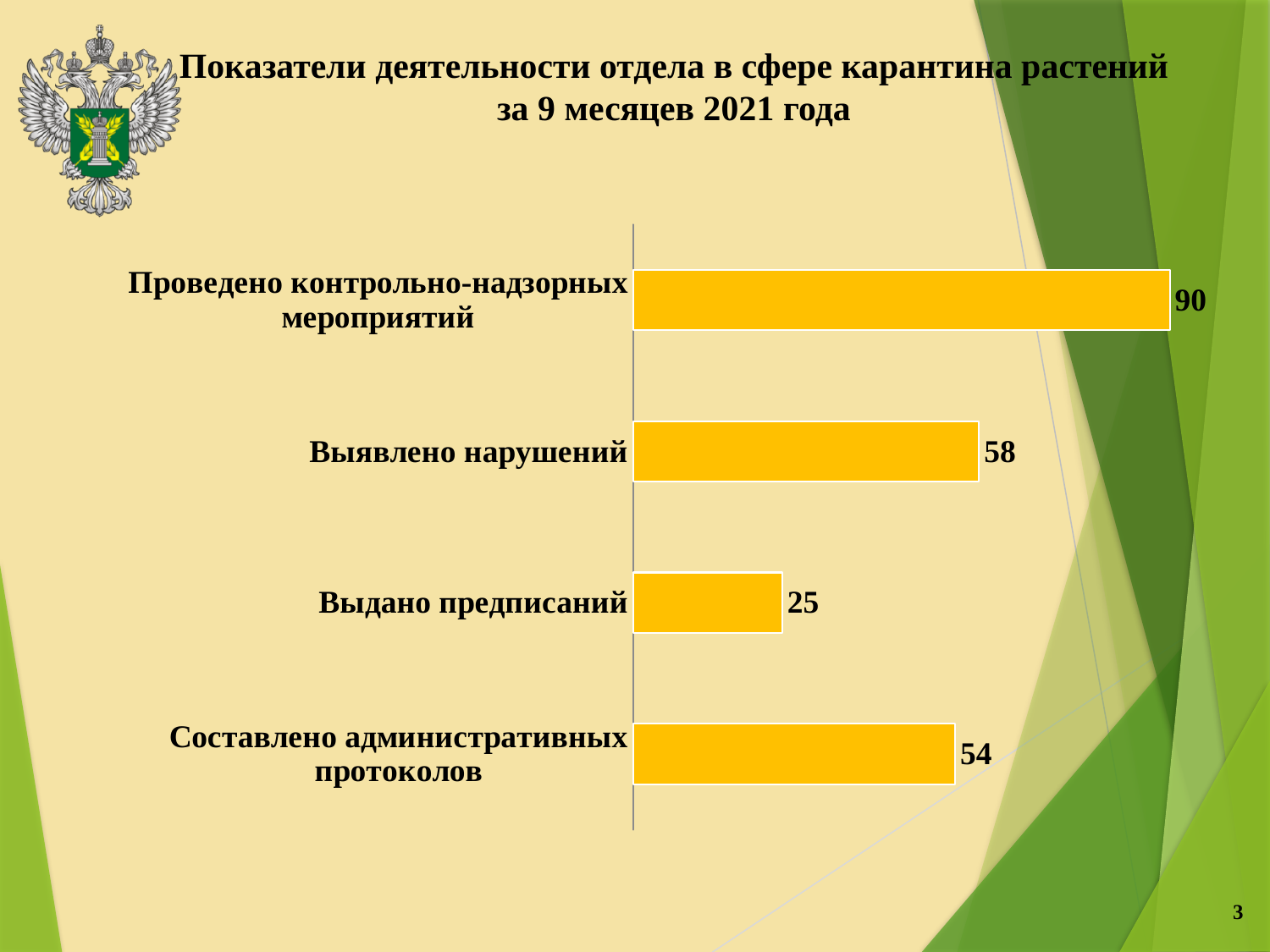
Which is larger: «Выявлено нарушений» or «Составлено административных протоколов»? Выявлено нарушений What kind of chart is shown on the slide? Bar chart What is the difference between «Проведено контрольно-надзорных мероприятий» and «Выявлено нарушений»? 32 What is the title of the slide? Показатели деятельности отдела в сфере карантина растений за 9 месяцев 2021 года What is the value for «Выявлено нарушений»? 58 Which category has the highest value? Проведено контрольно-надзорных мероприятий What is the value for «Выдано предписаний»? 25 What is the value for «Составлено административных протоколов»? 54 Which category has the lowest value? Выдано предписаний What is the difference between «Составлено административных протоколов» and «Выдано предписаний»? 29 What is the value for «Проведено контрольно-надзорных мероприятий»? 90 How many categories are shown in the chart? 4